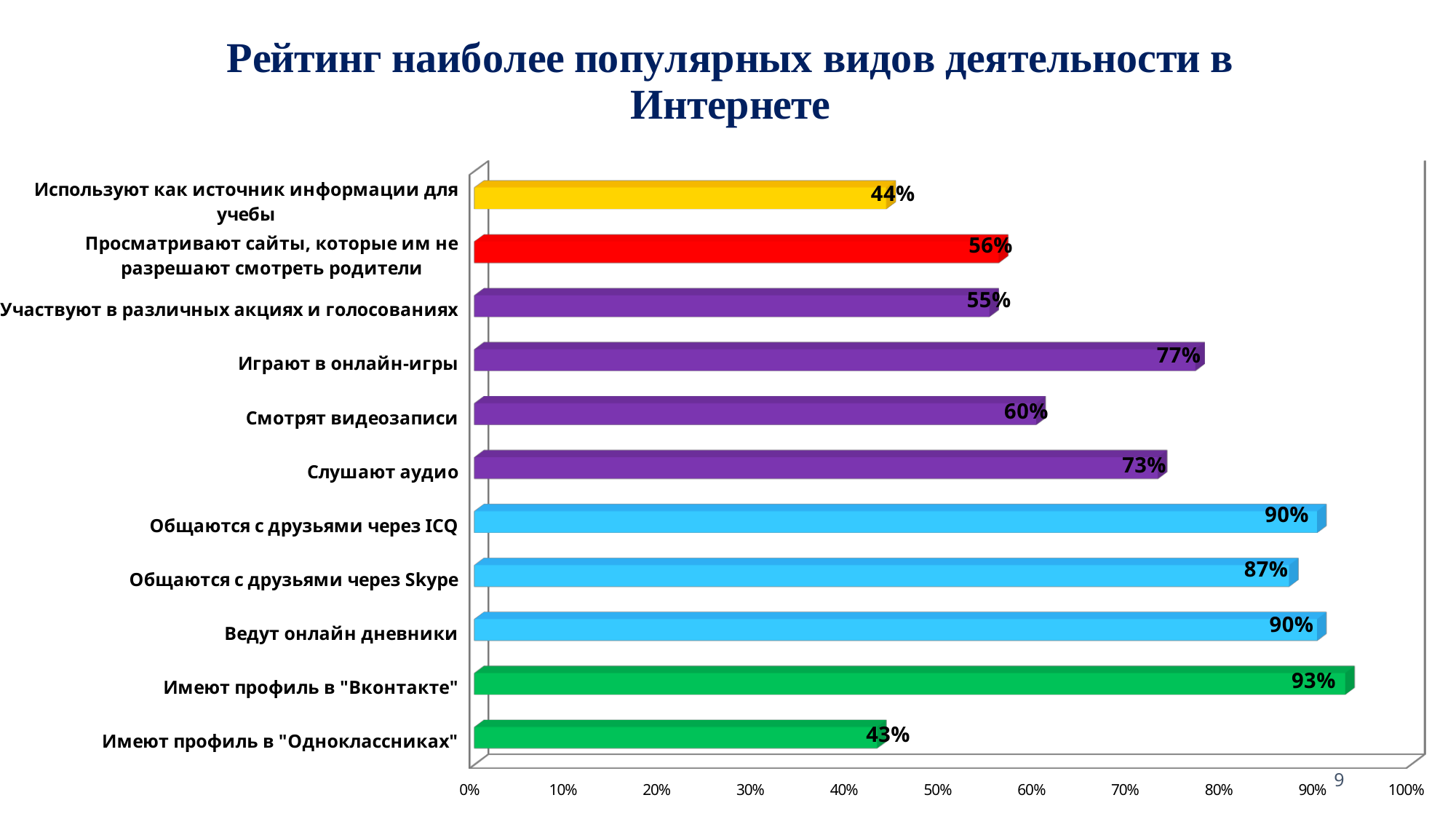
What value is shown for "Общаются с друзьями через Skype"? 87% What percentage is shown for "Используют как источник информации для учебы"? 44% What is the title of the slide? Рейтинг наиболее популярных видов деятельности в Интернете What kind of chart is shown on the slide? Bar chart How many categories are shown in the chart? 11 What percentage is shown for "Играют в онлайн-игры"? 77% What value is shown for "Смотрят видеозаписи"? 60% Which is larger: the value for "Общаются с друзьями через ICQ" or for "Общаются с друзьями через Skype"? Общаются с друзьями через ICQ Which category has the highest value? Имеют профиль в "Вконтакте" Which category has the lowest value? Имеют профиль в "Одноклассниках" What is the difference between the values for "Имеют профиль в "Вконтакте"" and "Имеют профиль в "Одноклассниках""? 50% What is the difference between the values for "Играют в онлайн-игры" and "Слушают аудио"? 4%